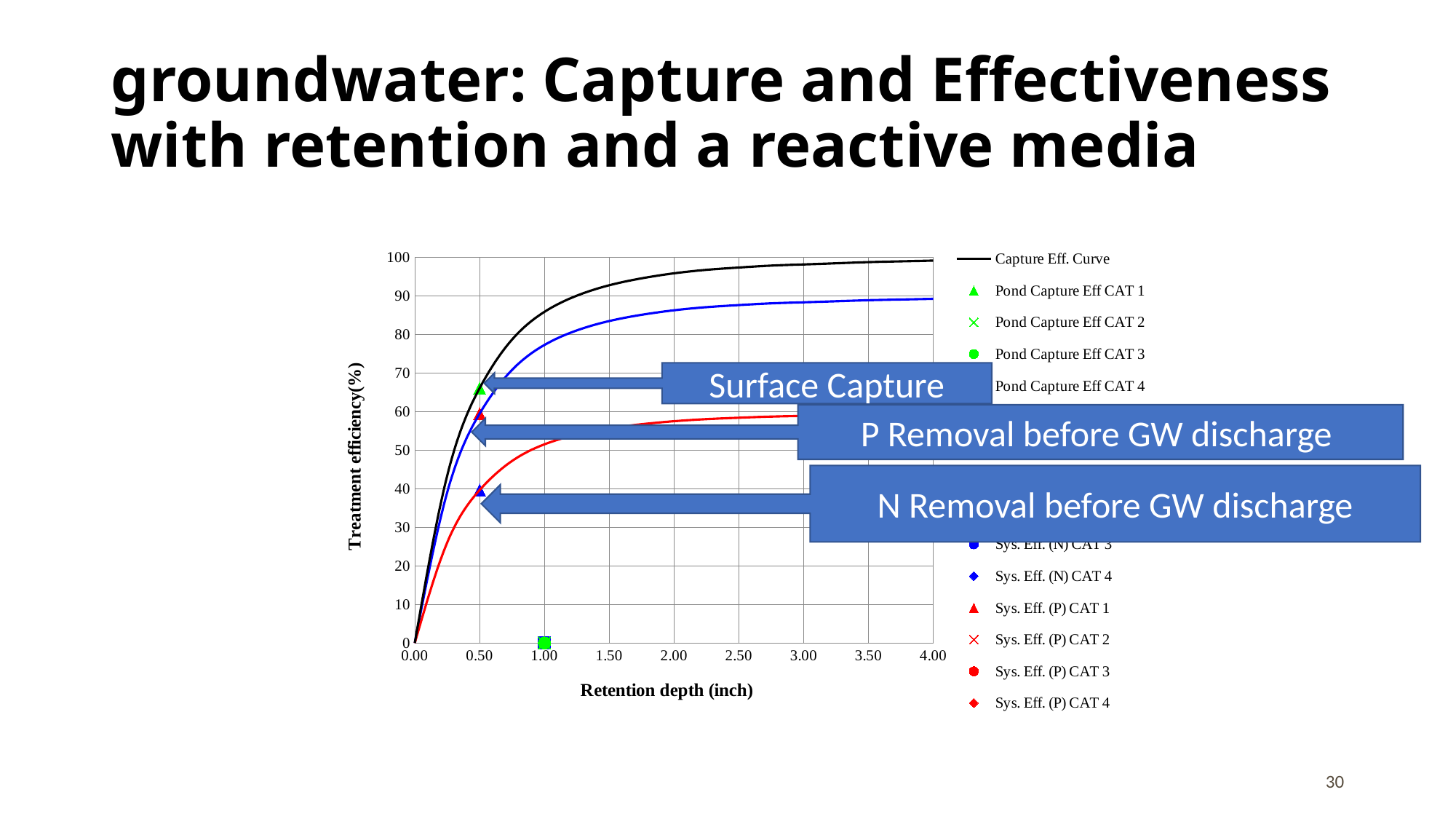
Is the value of the black Capture Eff. Curve at a retention depth of 1.00 greater or less than 80? greater At a retention depth of 2.00, is the blue curve or the red curve higher? the blue curve Do the curves rise or fall as retention depth increases? rise What is the title of the x axis of the chart? Retention depth (inch) Is the value of the blue curve at a retention depth of 4.00 greater or less than 80? greater What is the title of the y axis of the chart? Treatment efficiency(%) Which curve is highest at a retention depth of 4.00? the black Capture Eff. Curve Is the value of the red curve at a retention depth of 3.00 greater or less than 50? greater What kind of chart is shown on the slide? line chart Which curve is lowest at a retention depth of 2.00? the red curve